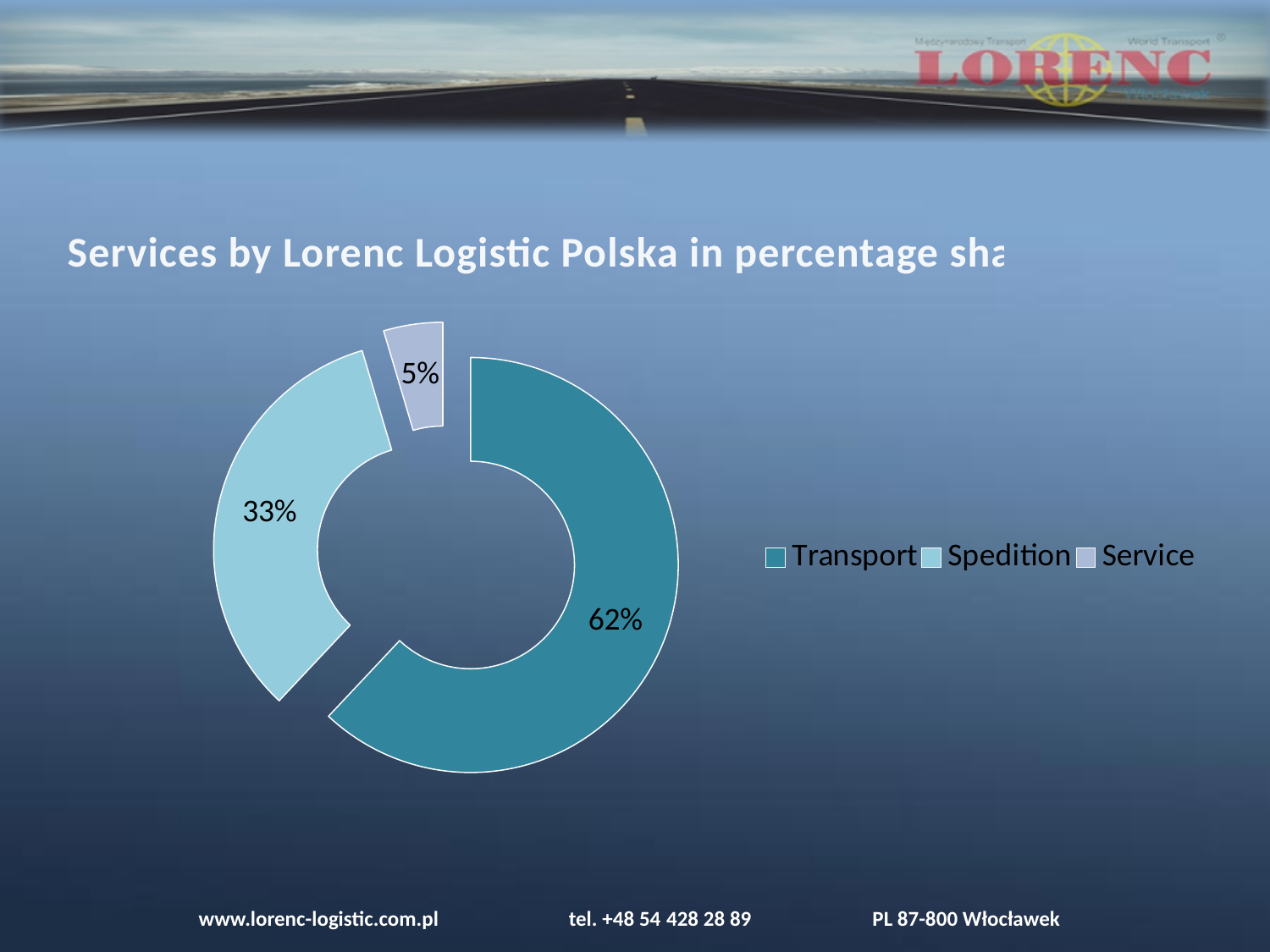
Which has a larger share, Spedition or Service? Spedition Which category is shown in the lightest (lavender) colour in the chart? Service What percentage share does Transport have in the chart? 62% What is the difference in percentage points between the Spedition and Service shares? 28 How many categories are shown in the chart? 3 Which service has the largest share in the chart? Transport What is the difference in percentage points between the Transport and Spedition shares? 29 What percentage share does Service have in the chart? 5% Which service has the smallest share in the chart? Service What percentage share does Spedition have in the chart? 33% What are the three entries listed in the chart legend? Transport, Spedition, Service What kind of chart is shown on the slide? Doughnut chart